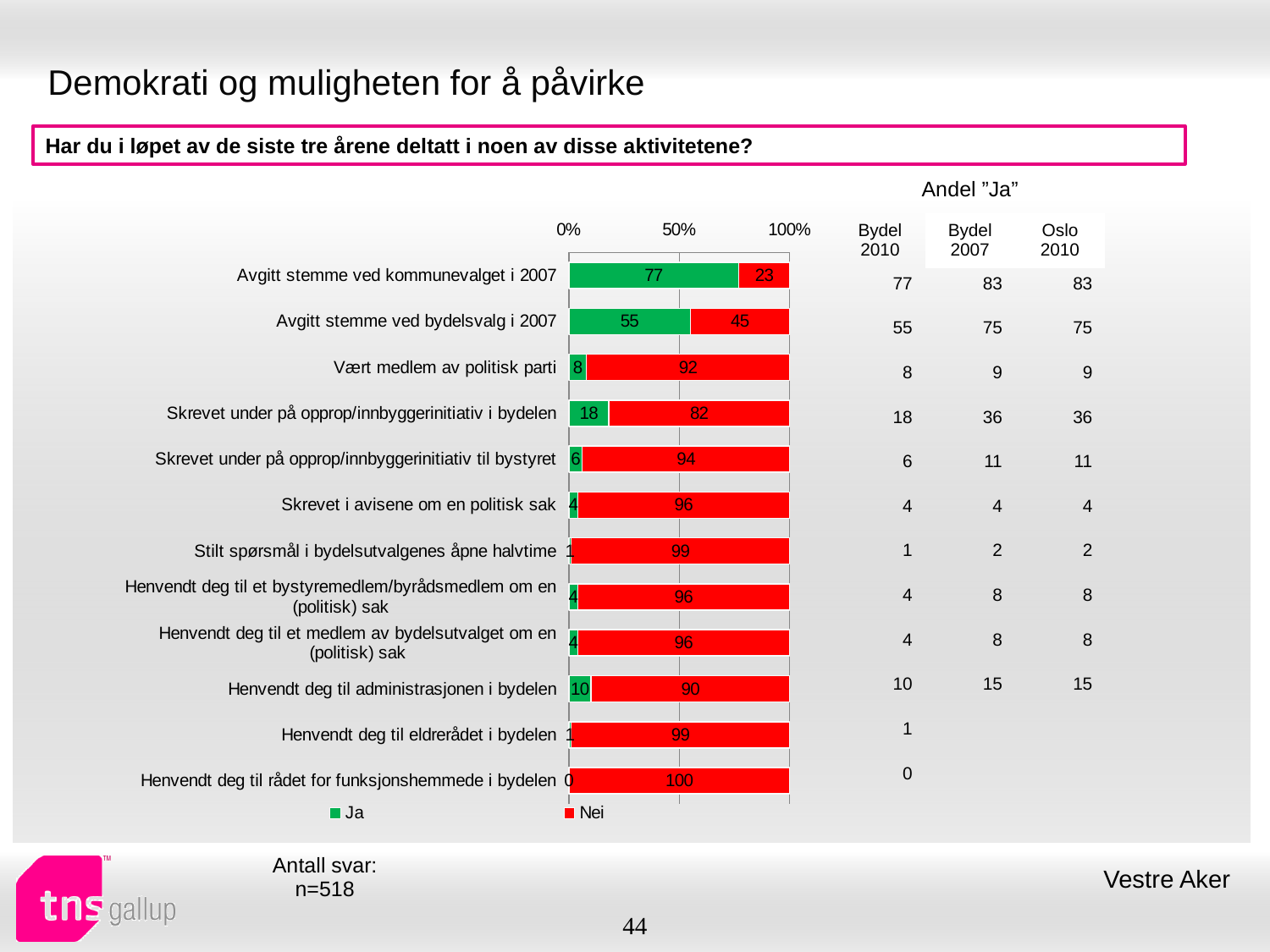
What kind of chart is shown on the slide? Stacked bar chart Which has a larger "Ja" value: "Skrevet under på opprop/innbyggerinitiativ i bydelen" or "Vært medlem av politisk parti"? Skrevet under på opprop/innbyggerinitiativ i bydelen Which colour represents the "Nei" series in the chart? Red What is the difference between the "Ja" values for "Avgitt stemme ved kommunevalget i 2007" and "Avgitt stemme ved bydelsvalg i 2007"? 22 Which category has the highest "Ja" value? Avgitt stemme ved kommunevalget i 2007 What is the "Nei" value for "Avgitt stemme ved bydelsvalg i 2007"? 45 What is the total of the stacked bar for "Vært medlem av politisk parti"? 100 What is the "Ja" value for "Henvendt deg til administrasjonen i bydelen"? 10 How many categories are shown in the chart? 12 What is the "Ja" value for "Avgitt stemme ved kommunevalget i 2007"? 77 Which category has the lowest "Ja" value? Henvendt deg til rådet for funksjonshemmede i bydelen How many series does the legend list? 2